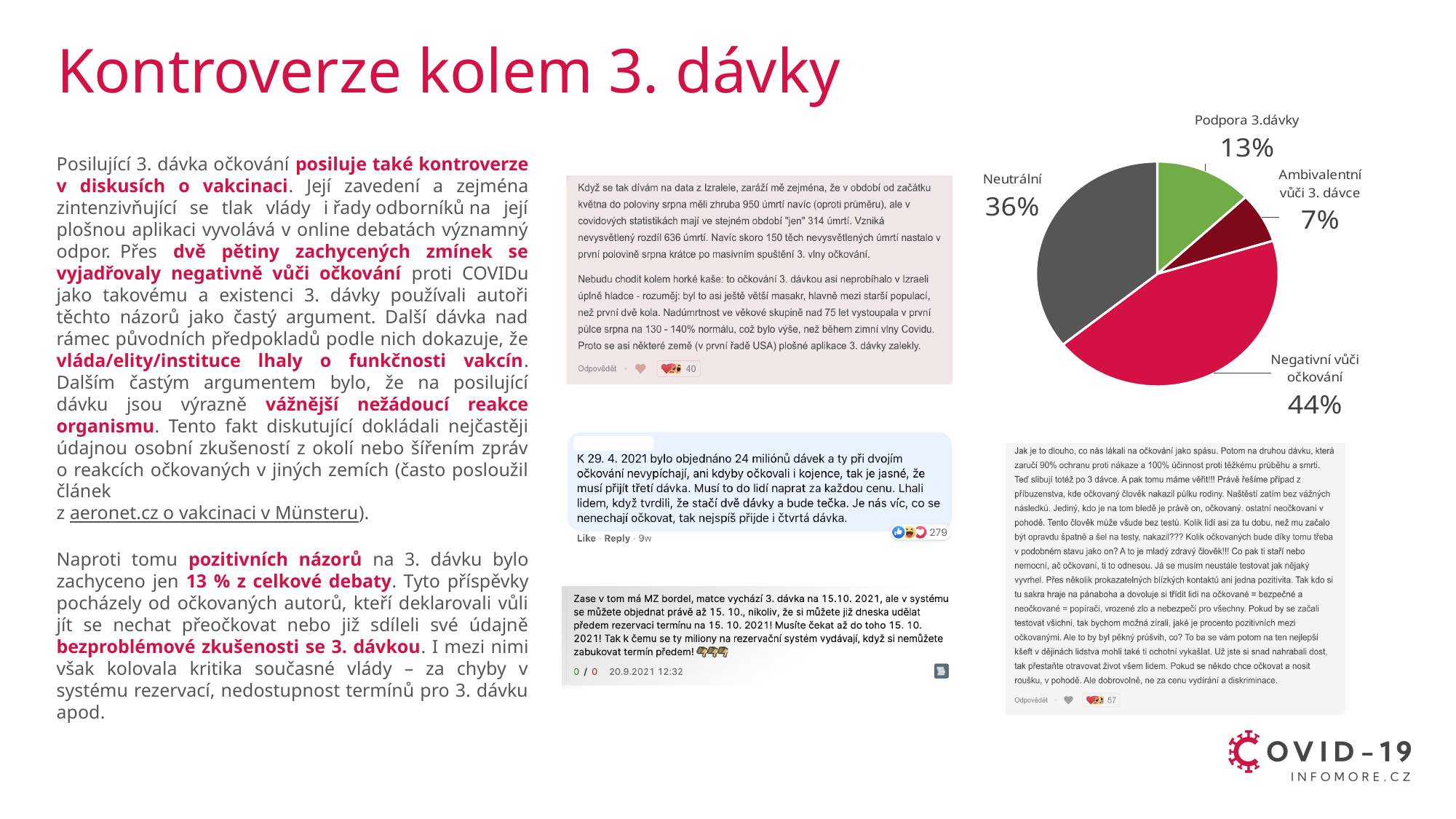
What share of the pie is labelled "Ambivalentní vůči 3. dávce"? 7% What share of the pie is labelled "Podpora 3.dávky"? 13% What is the difference in percentage points between the "Negativní vůči očkování" slice and the "Neutrální" slice? 8 percentage points What share of the pie is labelled "Negativní vůči očkování"? 44% How many slices does the pie chart have? 4 Which slice of the pie chart is the largest? Negativní vůči očkování What is the combined share of the "Podpora 3.dávky" and "Ambivalentní vůči 3. dávce" slices? 20% What kind of chart is shown on the slide? pie chart Which is larger in the pie chart: "Podpora 3.dávky" or "Ambivalentní vůči 3. dávce"? Podpora 3.dávky What colour is the "Neutrální" slice of the pie chart? grey What share of the pie is labelled "Neutrální"? 36% Which slice of the pie chart is the smallest? Ambivalentní vůči 3. dávce